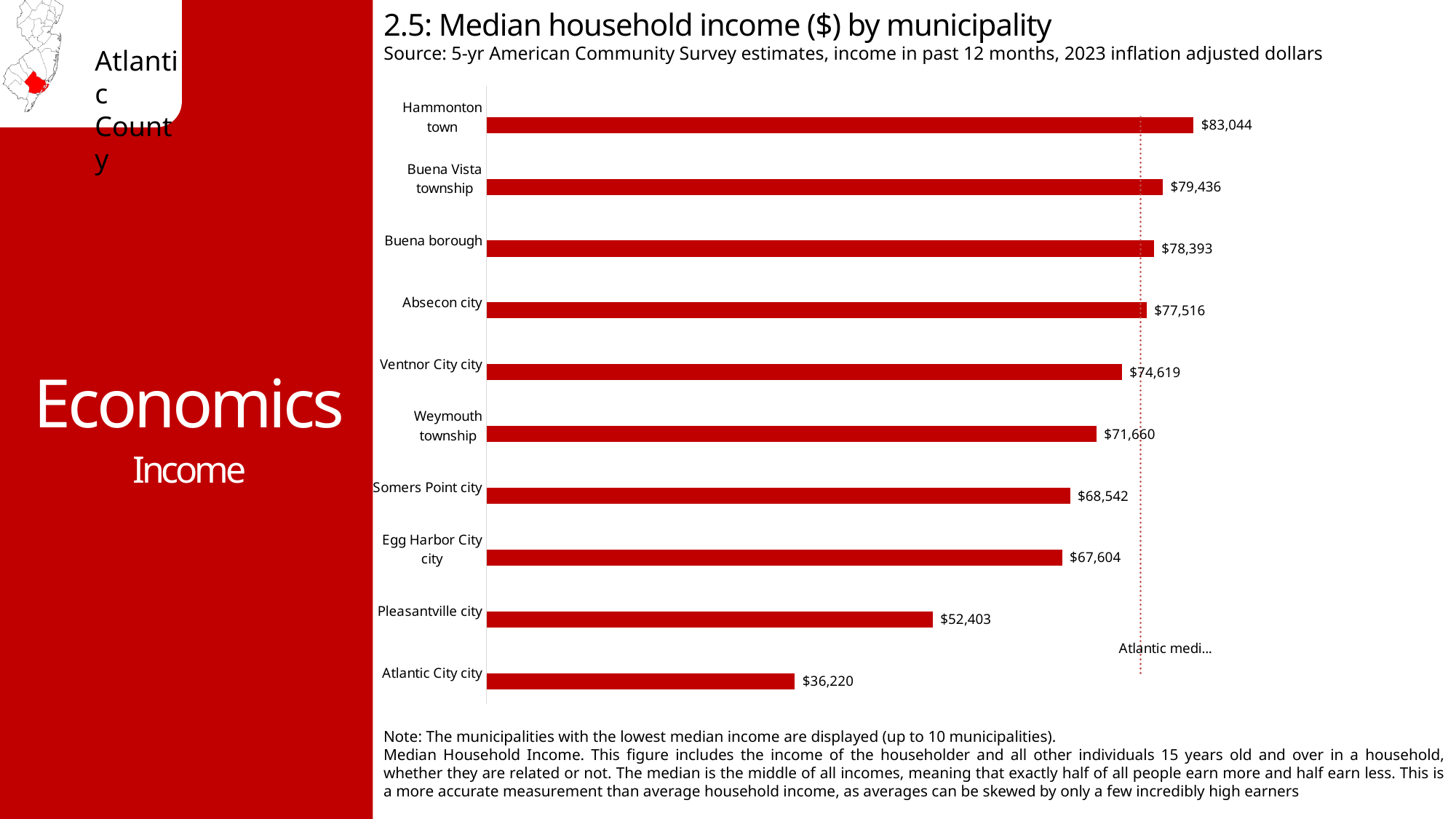
What is the median household income for Hammonton town? $83,044 What is the median household income for Atlantic City city? $36,220 What is the difference in median household income between Hammonton town and Atlantic City city? $46,824 Which municipality has the lowest median household income shown on the chart? Atlantic City city Which municipality has the highest median household income shown on the chart? Hammonton town What is the difference in median household income between Pleasantville city and Atlantic City city? $16,183 Which has a higher median household income, Absecon city or Ventnor City city? Absecon city How many municipalities are shown on the chart? 10 What kind of chart is used to show median household income by municipality? Bar chart What is the median household income for Weymouth township? $71,660 What is the median household income for Somers Point city? $68,542 What is the title of the chart? 2.5: Median household income ($) by municipality